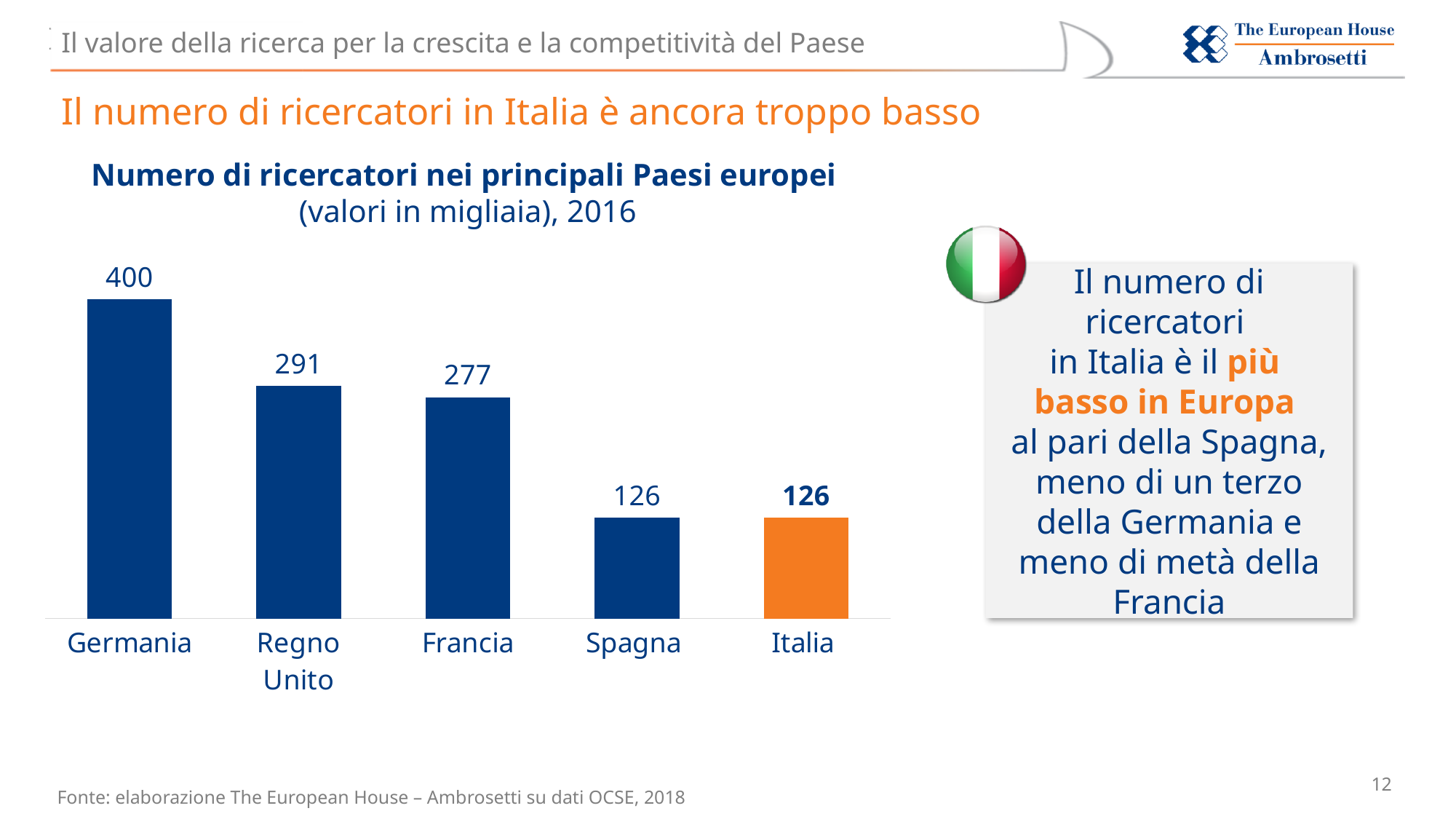
What is the value for Germania? 400 How many countries are shown in the chart? 5 What is the difference between the values for Germania and Francia? 123 Which country has the highest number of researchers? Germania What kind of chart is shown on the slide? Bar chart Which bar is coloured orange in the chart? Italia Do the values rise or fall from Germania to Spagna along the x axis? Fall What is the value for Francia? 277 What is the value for Italia? 126 What is the difference between the values for Regno Unito and Italia? 165 What is the value for Regno Unito? 291 Which is larger, the value for Regno Unito or the value for Francia? Regno Unito